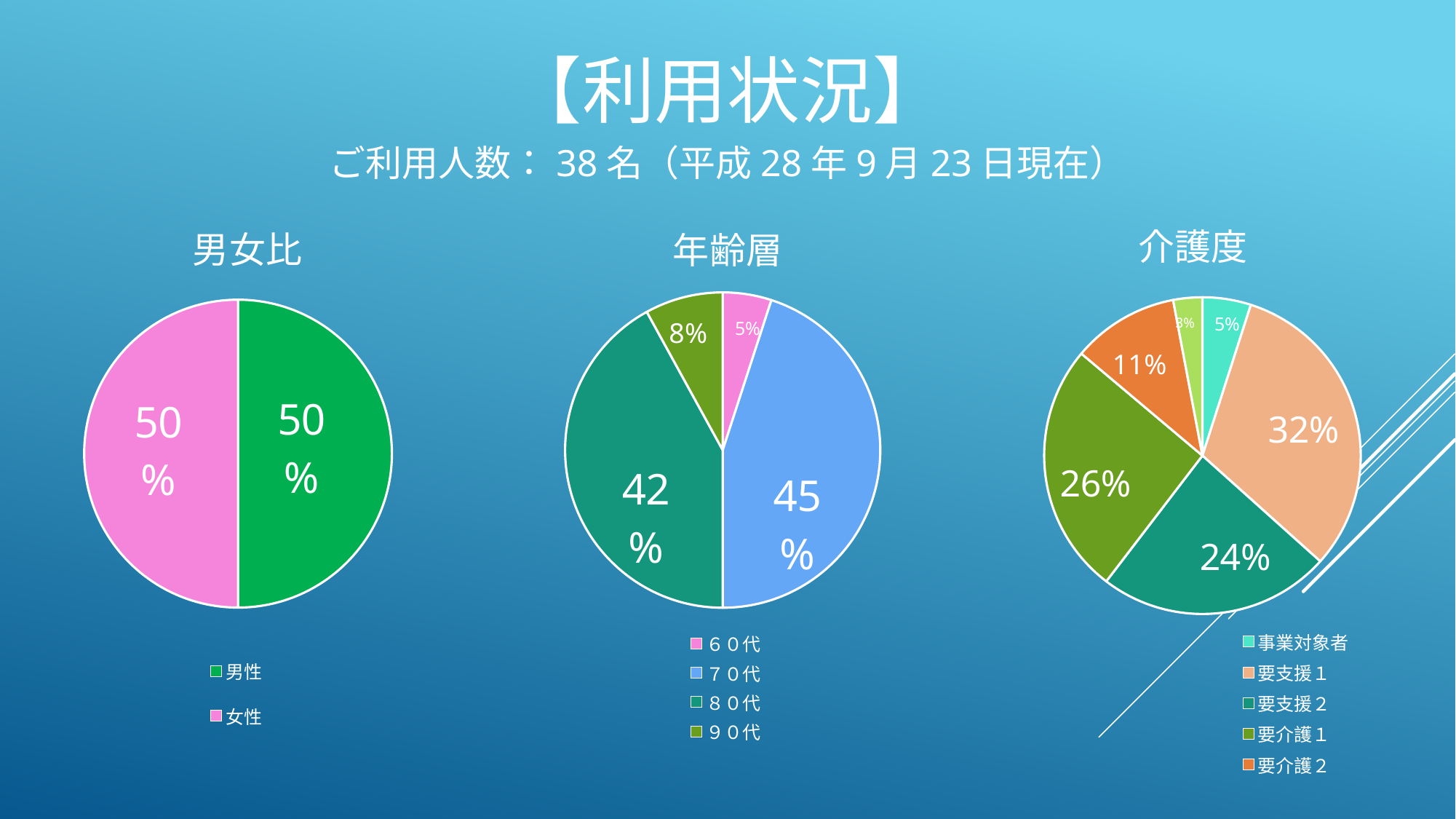
How many categories does the legend of the 年齢層 chart list? 4 In the 年齢層 chart, which age group has the smallest share? ６０代 In the 介護度 chart, what percentage is 要介護２? 11% In the 年齢層 chart, what is the difference between the ７０代 and ８０代 shares? 3% In the 男女比 chart, what percentage is 男性? 50% In the 介護度 chart, what percentage is 要支援１? 32% In the 年齢層 chart, which age group has the largest share? ７０代 How many entries does the legend of the 介護度 chart list? 5 In the 介護度 chart, which is larger, 要介護１ or 要支援２? 要介護１ In the 年齢層 chart, what percentage is ９０代? 8% In the 年齢層 chart, what percentage is ７０代? 45% What kind of chart is the 年齢層 chart? pie chart